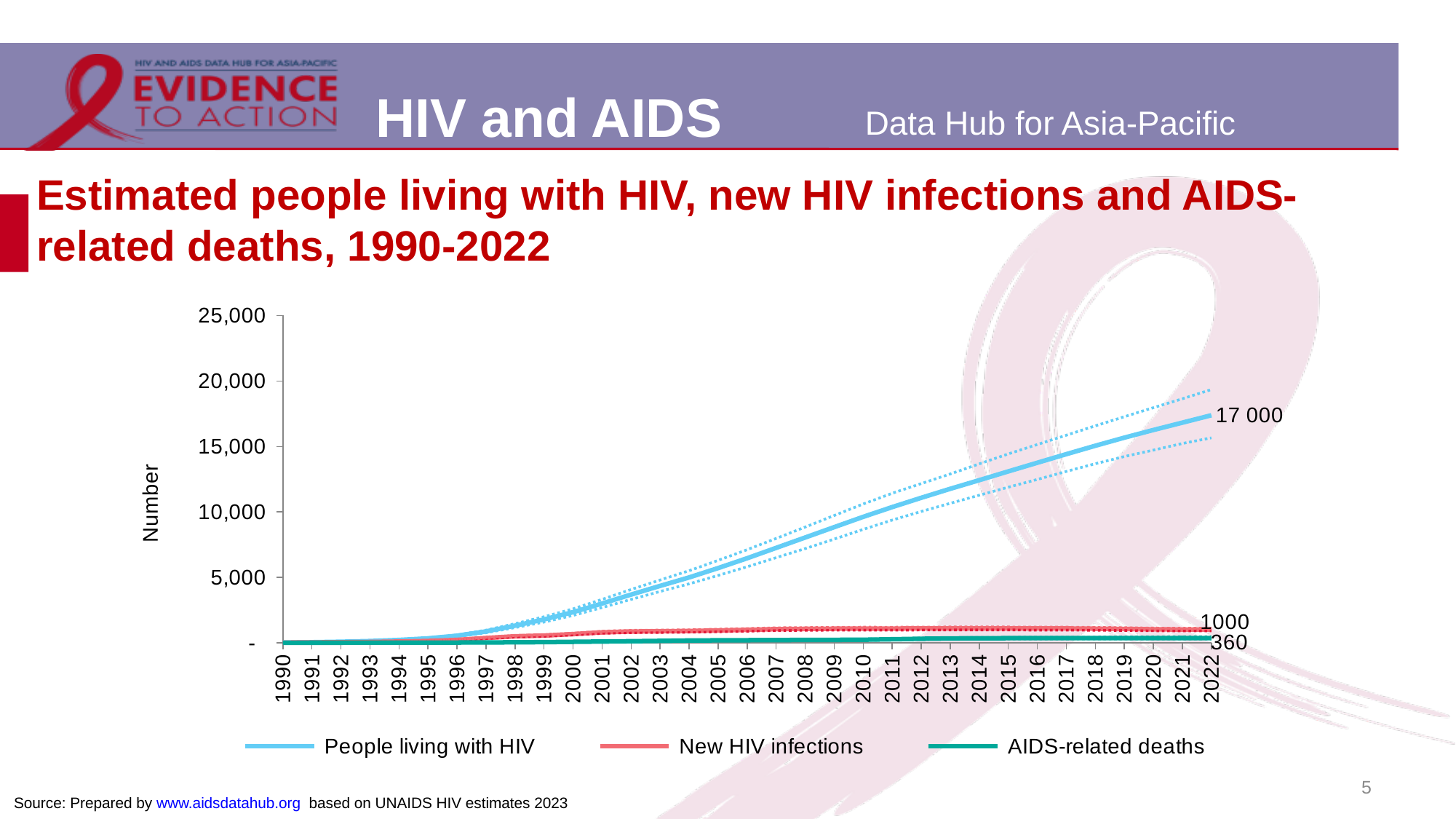
Is the value for People living with HIV in 2010 greater or less than 15,000? less Does the People living with HIV line rise or fall from 1990 to 2022? rise What kind of chart is shown on the slide? line chart Which is larger in 2022: New HIV infections or AIDS-related deaths? New HIV infections Which series has the highest value in 2022? People living with HIV Which series has the lowest value in 2022? AIDS-related deaths What is the value for AIDS-related deaths in 2022? 360 What is the value for People living with HIV in 2022? 17 000 How many series does the legend list? 3 What is the value for New HIV infections in 2022? 1000 What is the difference between People living with HIV and New HIV infections in 2022? 16 000 What is the difference between New HIV infections and AIDS-related deaths in 2022? 640